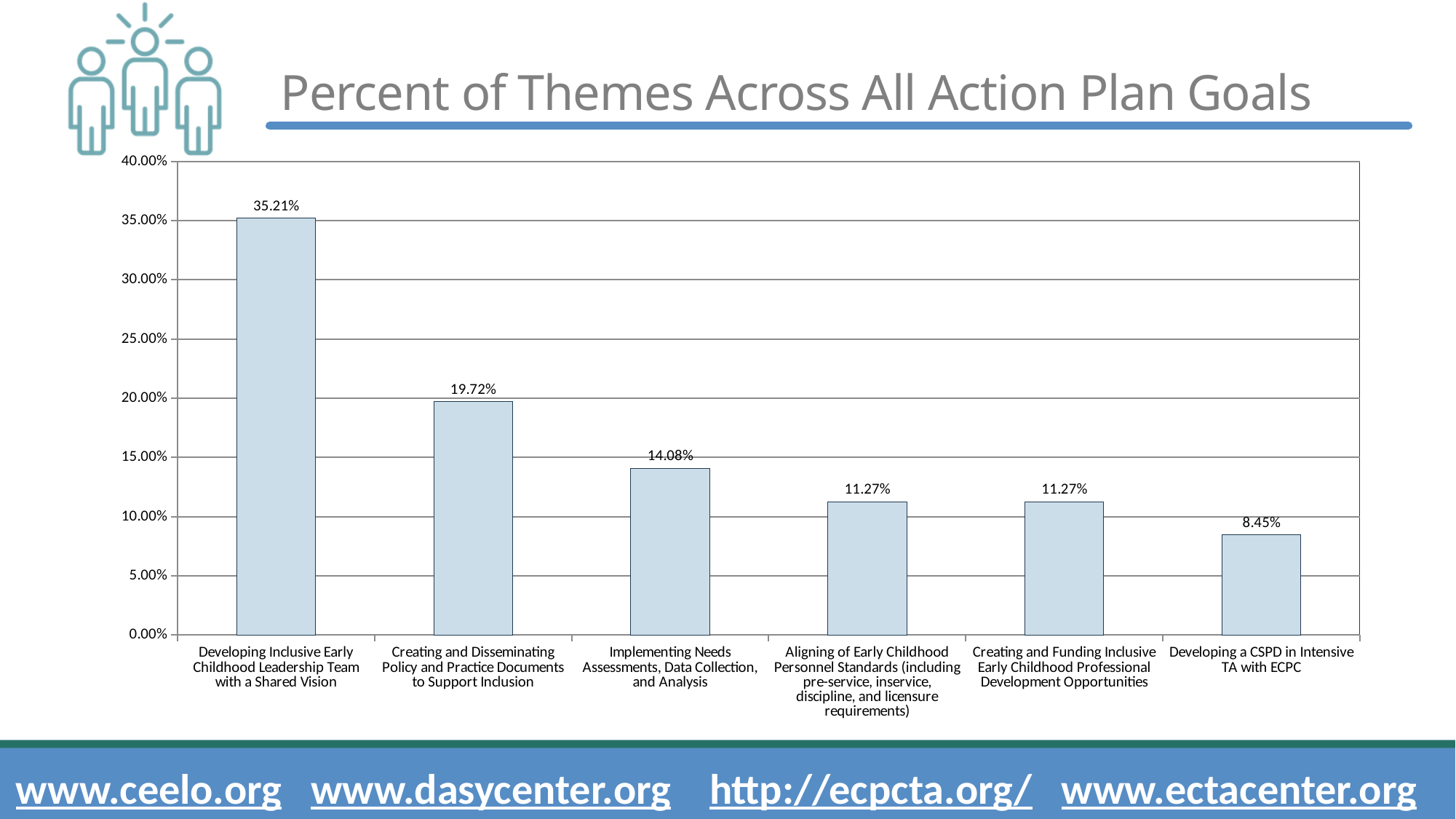
What is the value for Implementing Needs Assessments, Data Collection, and Analysis? 14.08% What is the title of the chart? Percent of Themes Across All Action Plan Goals What is the difference between the values for Developing Inclusive Early Childhood Leadership Team with a Shared Vision and Creating and Disseminating Policy and Practice Documents to Support Inclusion? 15.49% What is the value for Developing a CSPD in Intensive TA with ECPC? 8.45% What is the value for Developing Inclusive Early Childhood Leadership Team with a Shared Vision? 35.21% What kind of chart is shown on the slide? Bar chart Which category has the highest value? Developing Inclusive Early Childhood Leadership Team with a Shared Vision Which category has the lowest value? Developing a CSPD in Intensive TA with ECPC How many categories are shown on the chart? 6 Which is larger: the value for Implementing Needs Assessments, Data Collection, and Analysis or the value for Developing a CSPD in Intensive TA with ECPC? Implementing Needs Assessments, Data Collection, and Analysis Do the values rise or fall from left to right along the x axis? Fall What is the value for Creating and Disseminating Policy and Practice Documents to Support Inclusion? 19.72%